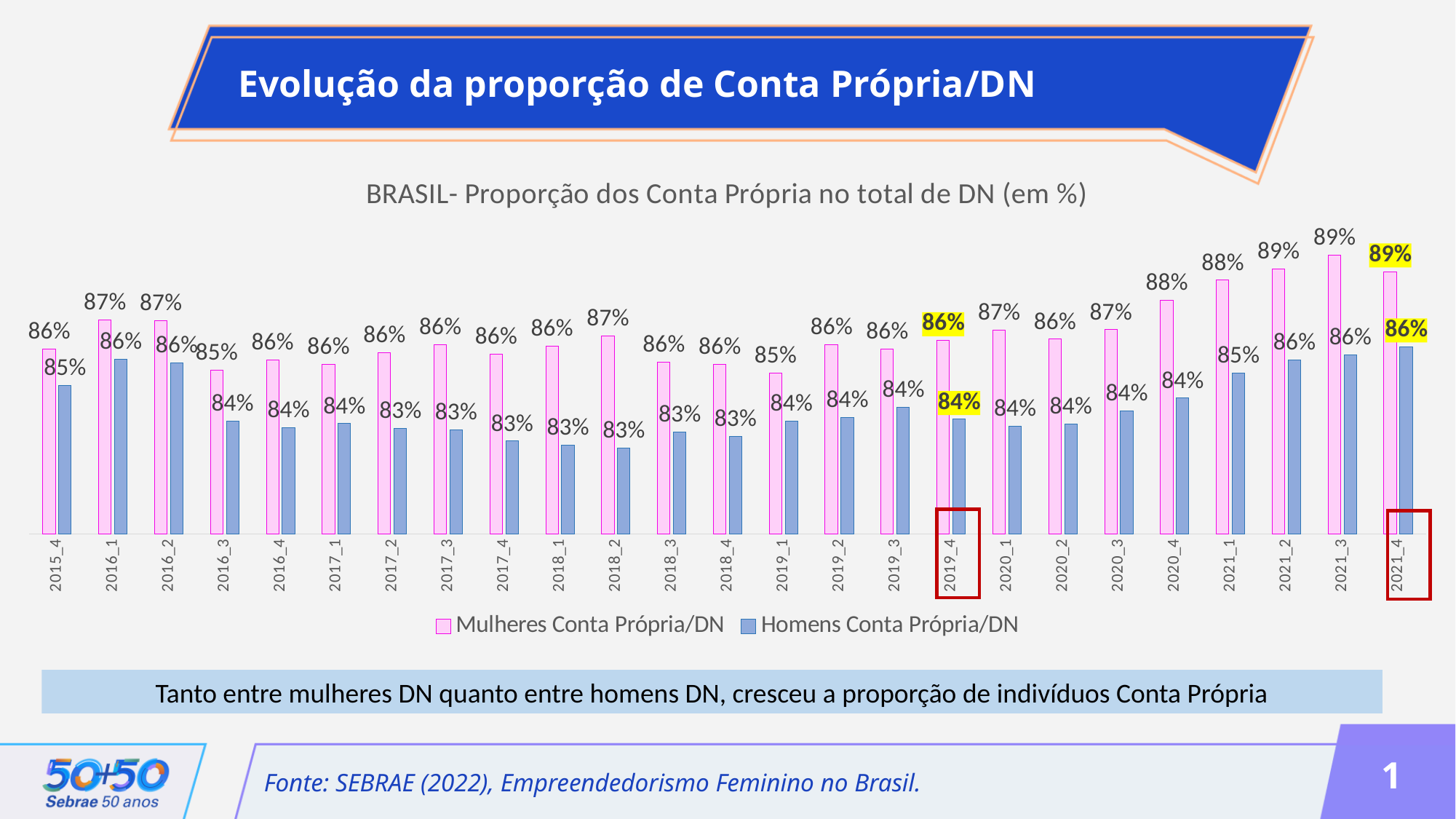
What kind of chart is shown on the slide? Bar chart Do the Mulheres Conta Própria/DN values rise or fall from 2019_4 to 2021_4? Rise What is the value for Homens Conta Própria/DN in 2018_2? 83% What is the value for Mulheres Conta Própria/DN in 2015_4? 86% What is the highest value shown for Mulheres Conta Própria/DN? 89% In 2016_1, which series has the larger value, Mulheres Conta Própria/DN or Homens Conta Própria/DN? Mulheres Conta Própria/DN What is the value for Mulheres Conta Própria/DN in 2021_4? 89% What is the difference between the Homens Conta Própria/DN values in 2015_4 and 2018_2? 2 percentage points What is the difference between the Mulheres and Homens values in 2021_4? 3 percentage points How many quarters (categories) are shown on the x axis? 25 What is the value for Homens Conta Própria/DN in 2019_4? 84% How many series does the legend list? 2